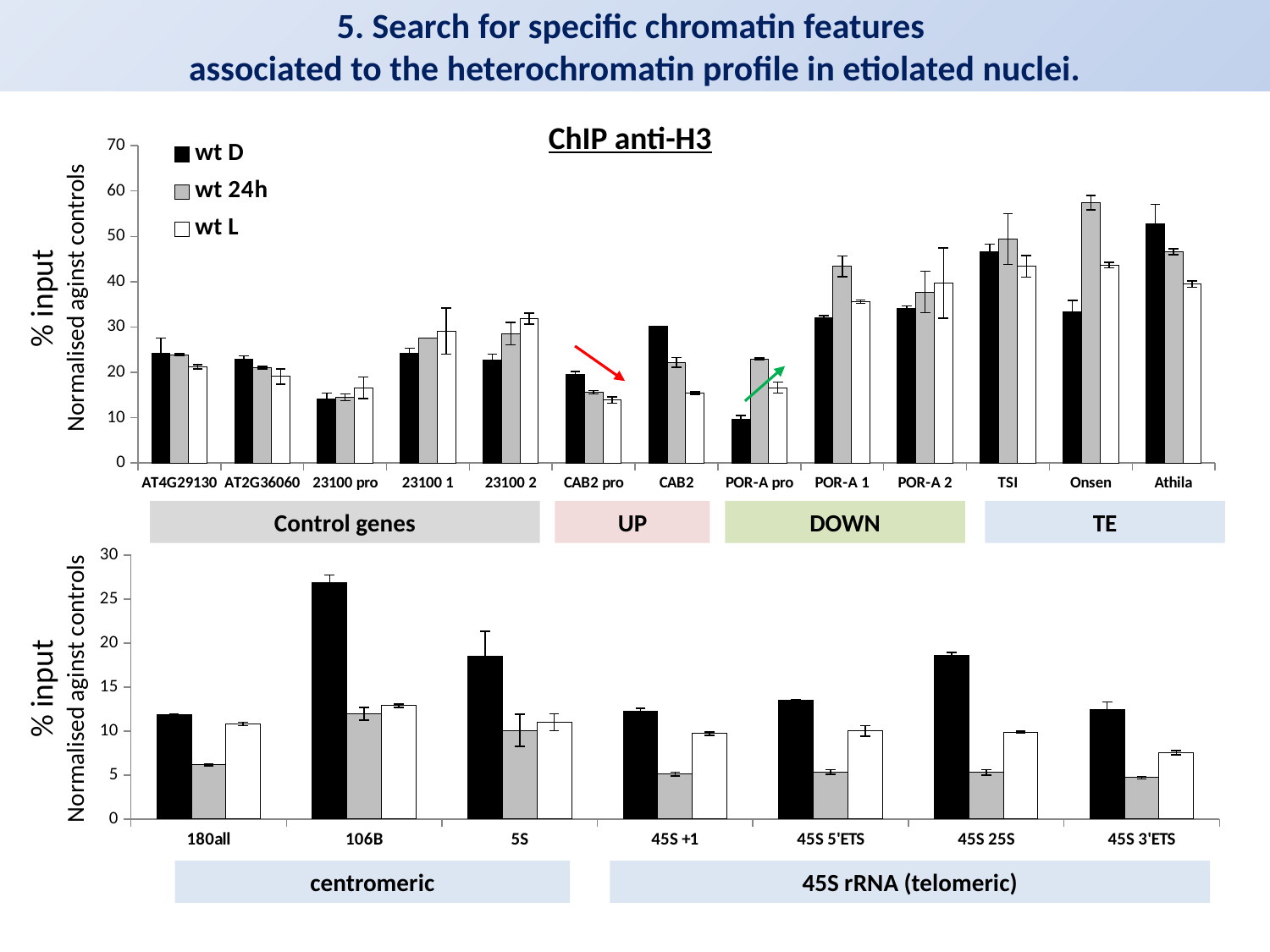
In the bottom chart, is the wt 24h value for 180all greater or less than 10? less In the top chart 'ChIP anti-H3', which category has the tallest bar overall? Onsen In the top chart 'ChIP anti-H3', which is larger for CAB2: the wt D value or the wt L value? wt D What is the title of the top chart? ChIP anti-H3 How many series does the legend of the top chart list? 3 In the bottom chart, is the wt D value for 106B greater or less than 25? greater In the top chart 'ChIP anti-H3', is the wt D value for 23100 pro greater or less than 20? less How many categories are shown on the x axis of the bottom chart? 7 What kind of chart is the top chart titled 'ChIP anti-H3'? bar chart How many categories are shown on the x axis of the top chart 'ChIP anti-H3'? 13 In the bottom chart, which category has the tallest bar? 106B